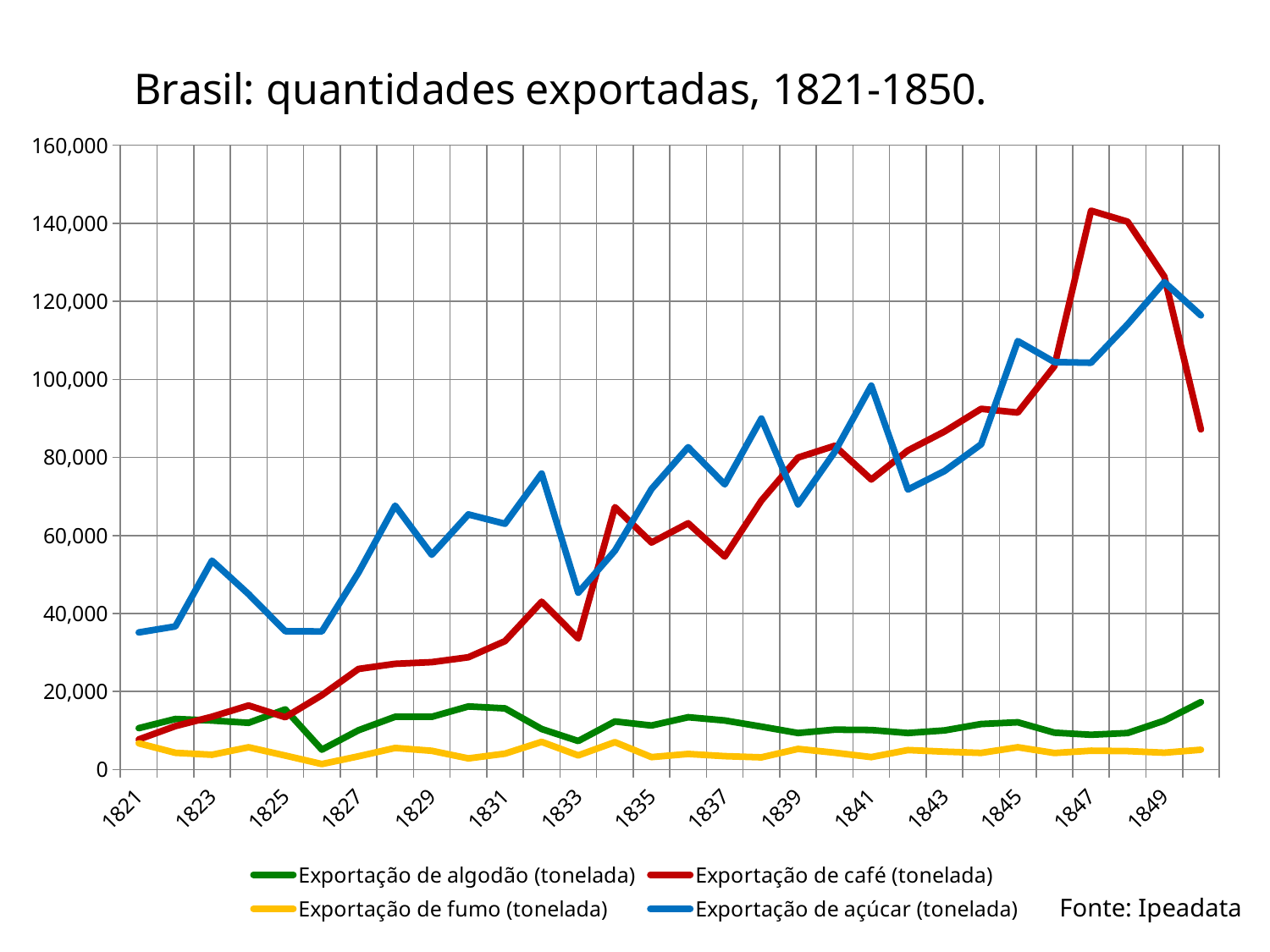
Is the value for Exportação de café in 1847 greater or less than 120,000? greater What kind of chart is shown on the slide? line chart Which series has the lowest values across the whole period? Exportação de fumo (tonelada) Is the value for Exportação de açúcar in 1821 greater or less than 40,000? less Is the value for Exportação de açúcar in 1849 greater or less than 100,000? greater How many series does the legend list? 4 Which series has the highest value in 1847? Exportação de café (tonelada) What is the title of the chart? Brasil: quantidades exportadas, 1821-1850. In 1850, which is larger: Exportação de café or Exportação de açúcar? Exportação de açúcar How many years are plotted along the x axis? 30 Which series is drawn in blue? Exportação de açúcar (tonelada)